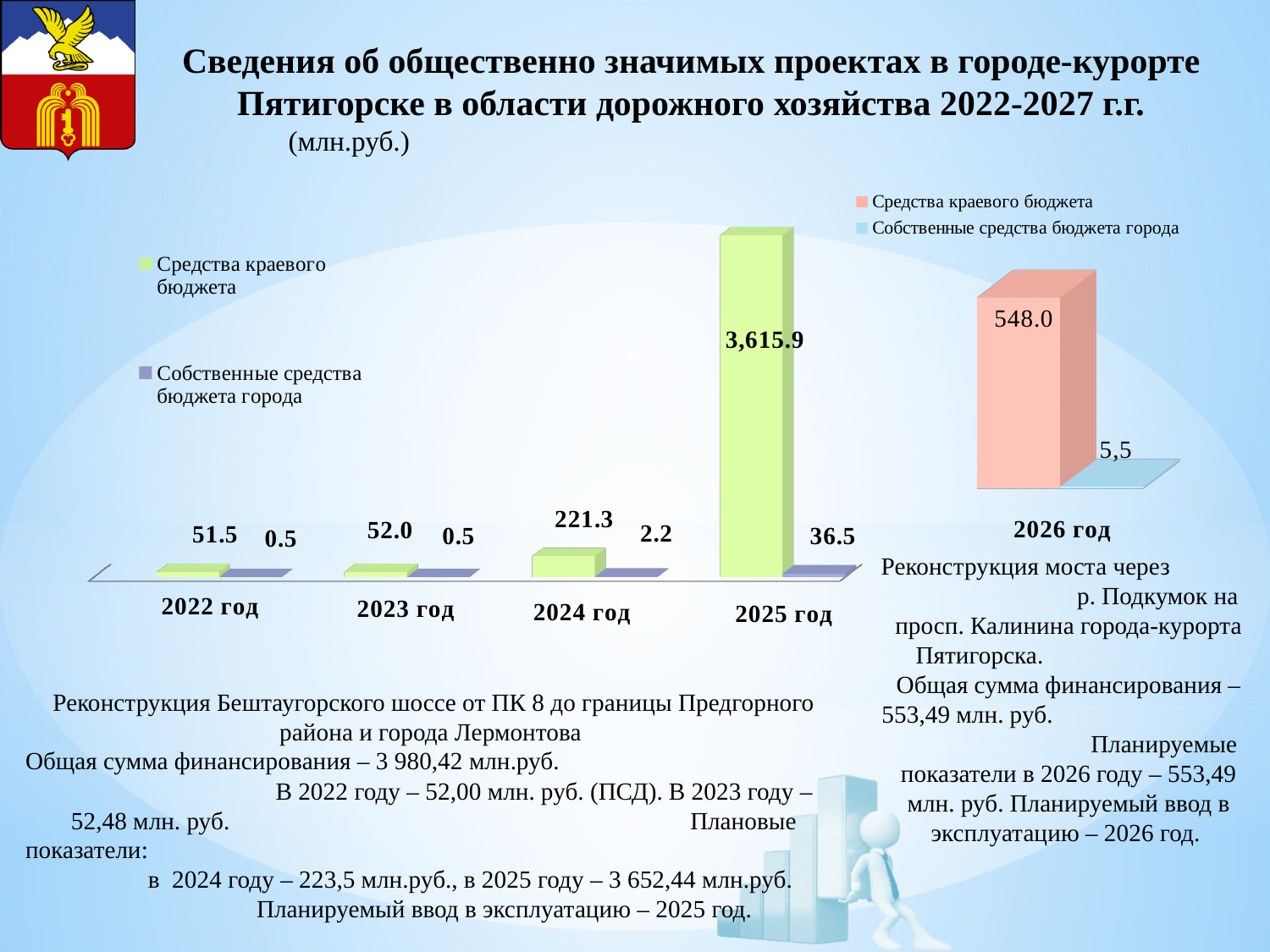
In the right chart, what is the value of Средства краевого бюджета for 2026 год? 548.0 What type of chart is the left chart? Bar chart In the left chart, what is the value of Средства краевого бюджета for 2022 год? 51.5 In the left chart, what is the value of Собственные средства бюджета города for 2024 год? 2.2 How many series does the legend of the left chart list? 2 In the left chart, what is the difference between Средства краевого бюджета for 2024 год and 2023 год? 169.3 In the left chart, which year has the lowest value of Средства краевого бюджета? 2022 год In the left chart, which is larger: Собственные средства бюджета города for 2025 год or for 2024 год? 2025 год In the left chart, which year has the highest value of Средства краевого бюджета? 2025 год In the left chart, what is the value of Средства краевого бюджета for 2025 год? 3,615.9 In the right chart, what is the value of Собственные средства бюджета города for 2026 год? 5,5 How many years are shown on the x axis of the left chart? 4